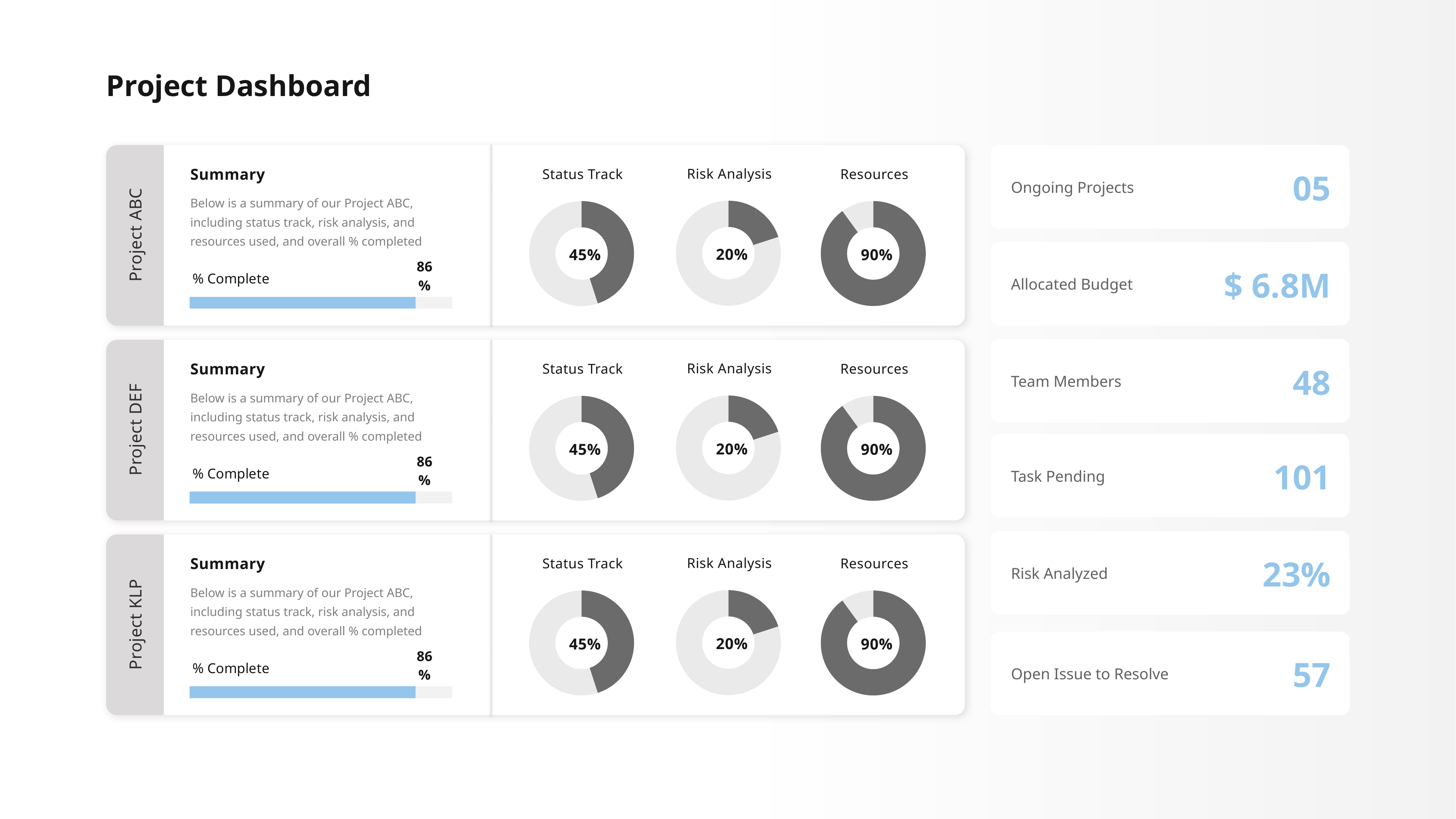
In the Project DEF row, what value is shown in the Resources donut chart? 90% In the Project ABC row, what is the difference between the Resources value and the Status Track value? 45% How many donut charts are shown in the Project KLP row? 3 In the Project DEF row, which is larger, the Status Track value or the Risk Analysis value? Status Track In the Project KLP row, which of the three donut charts shows the highest value? Resources In the Project ABC row, what value is shown in the Risk Analysis donut chart? 20% In the Project ABC row, what value is shown in the Status Track donut chart? 45% In the Project ABC row, what percentage does the % Complete progress bar show? 86% In the Project ABC row, what value is shown in the Resources donut chart? 90% In the Project DEF row, which of the three donut charts shows the lowest value? Risk Analysis In the Project KLP row, what value is shown in the Risk Analysis donut chart? 20% What kind of chart is used for Status Track, Risk Analysis and Resources in each project row? Donut chart